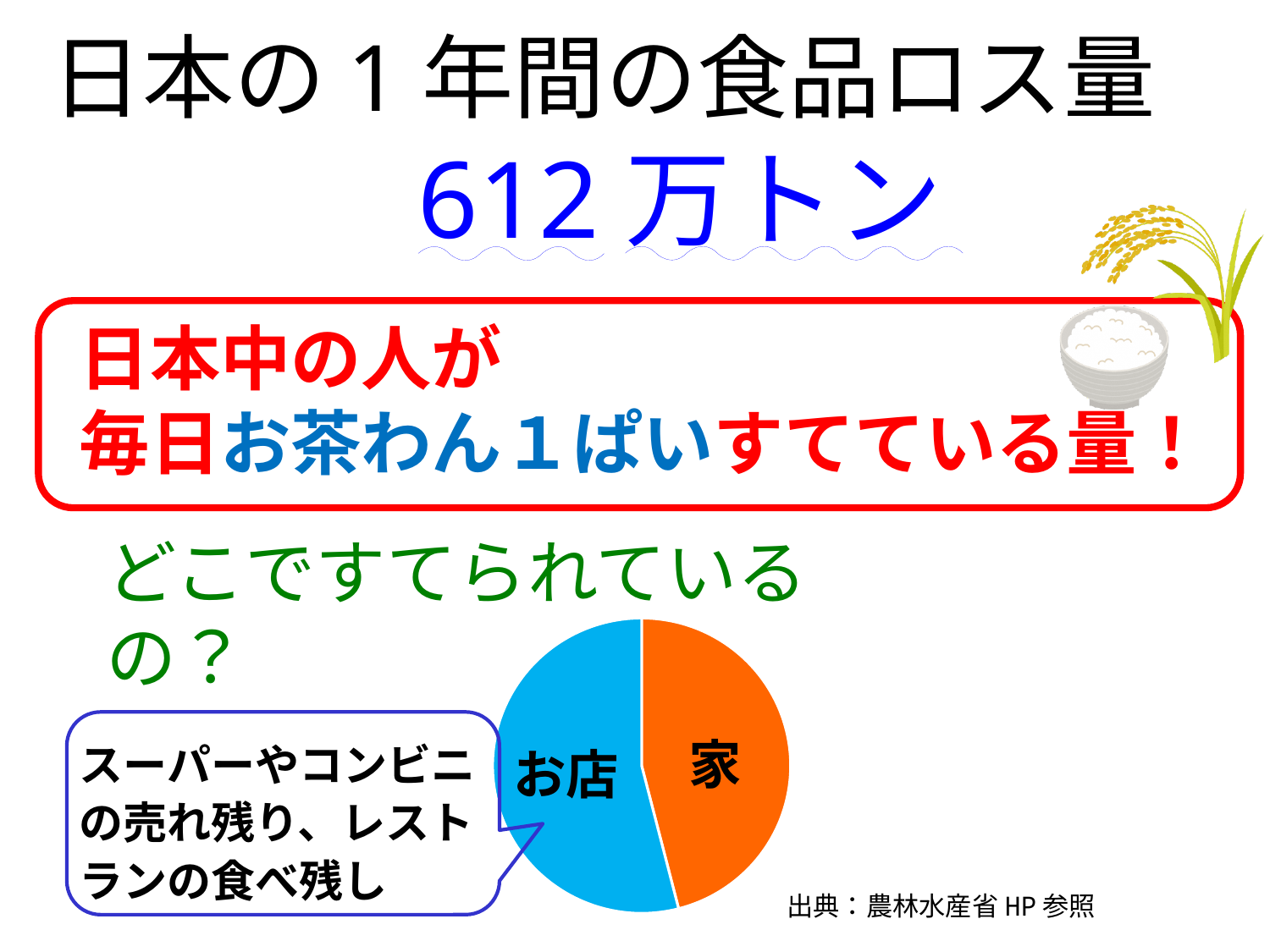
What colour is the 家 slice of the pie chart? orange Which slice of the pie chart is blue? お店 What kind of chart is shown on the slide? pie chart What are the labels of the two slices in the pie chart? お店 and 家 What question is written in green above the pie chart? どこですてられているの？ How many slices does the pie chart have? 2